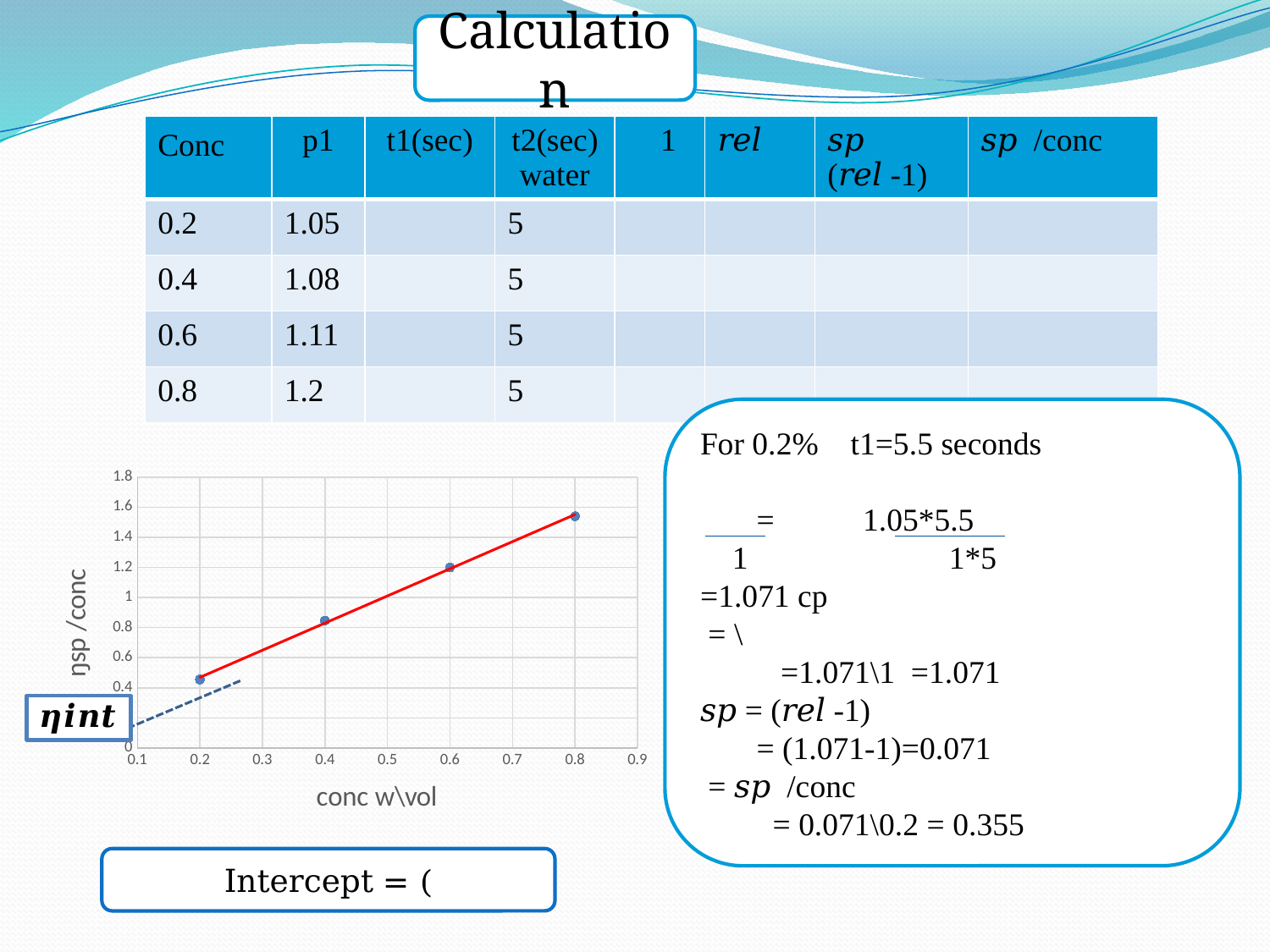
Which has the larger ŋsp/conc value: conc 0.4 or conc 0.6? 0.6 At which conc w\vol value is ŋsp/conc highest? 0.8 Is the ŋsp/conc value at conc 0.4 greater or less than 1? less Is the ŋsp/conc value at conc 0.2 greater or less than 0.4? greater What is the title of the x axis of the chart? conc w\vol Is the ŋsp/conc value at conc 0.8 greater or less than 1.4? greater What is the title of the y axis of the chart? ŋsp /conc Do the plotted values rise or fall as conc w\vol increases along the x axis? rise How many data points are plotted on the chart? 4 At which conc w\vol value is ŋsp/conc lowest? 0.2 What kind of chart is shown on the slide? scatter chart